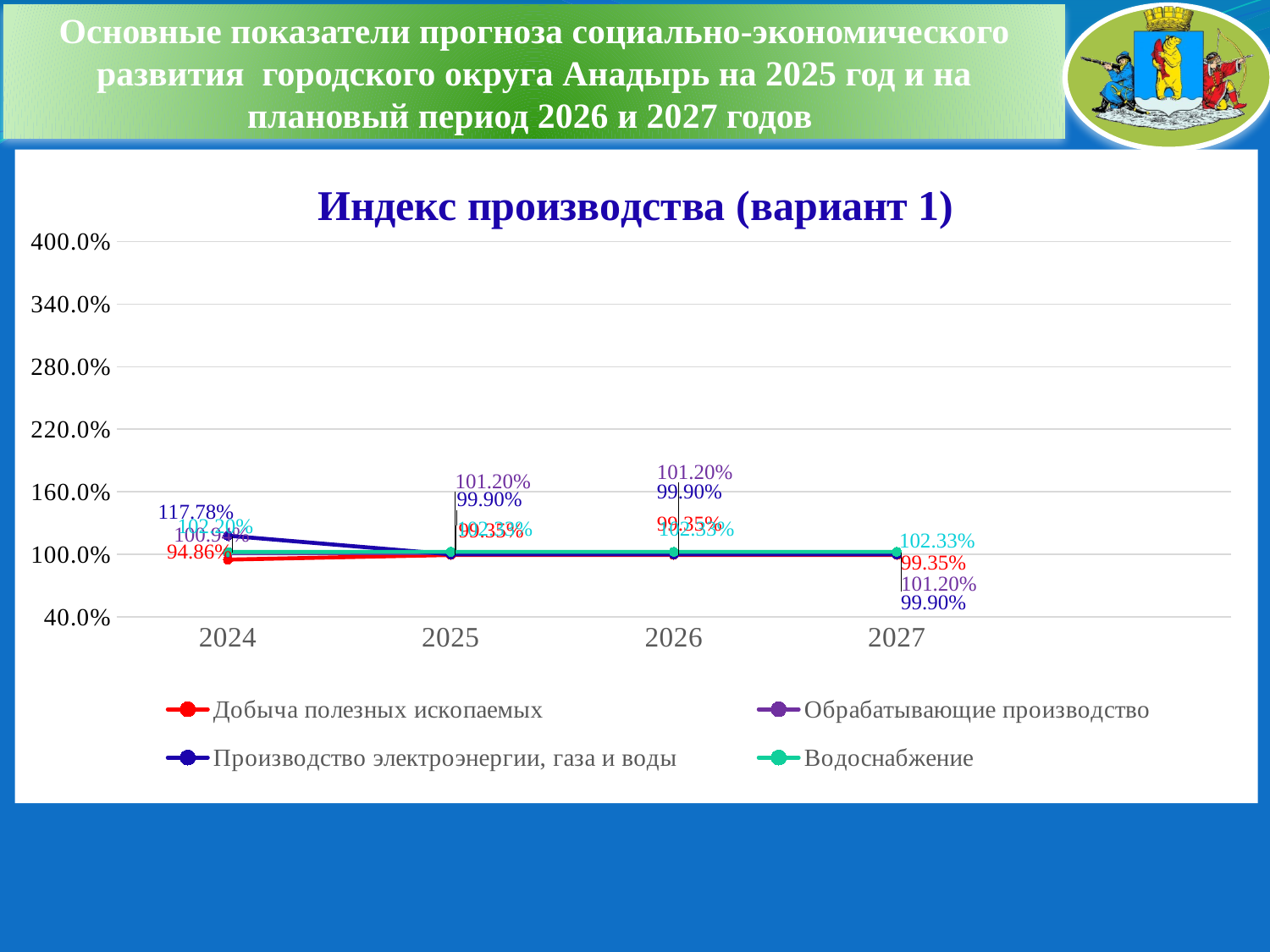
What kind of chart is shown on the slide? Line chart What is the value for Обрабатывающие производство in 2027? 101.20% What is the value for Добыча полезных ископаемых in 2027? 99.35% What is the value for Производство электроэнергии, газа и воды in 2024? 117.78% Which series has the highest value in 2024? Производство электроэнергии, газа и воды What is the value for Добыча полезных ископаемых in 2024? 94.86% Which series has the lowest value in 2024? Добыча полезных ископаемых What is the value for Водоснабжение in 2027? 102.33% Does the value for Производство электроэнергии, газа и воды rise or fall from 2024 to 2027? Fall How many years are shown on the x axis? 4 How many series does the legend list? 4 What is the difference between Водоснабжение and Добыча полезных ископаемых in 2027? 2.98 percentage points